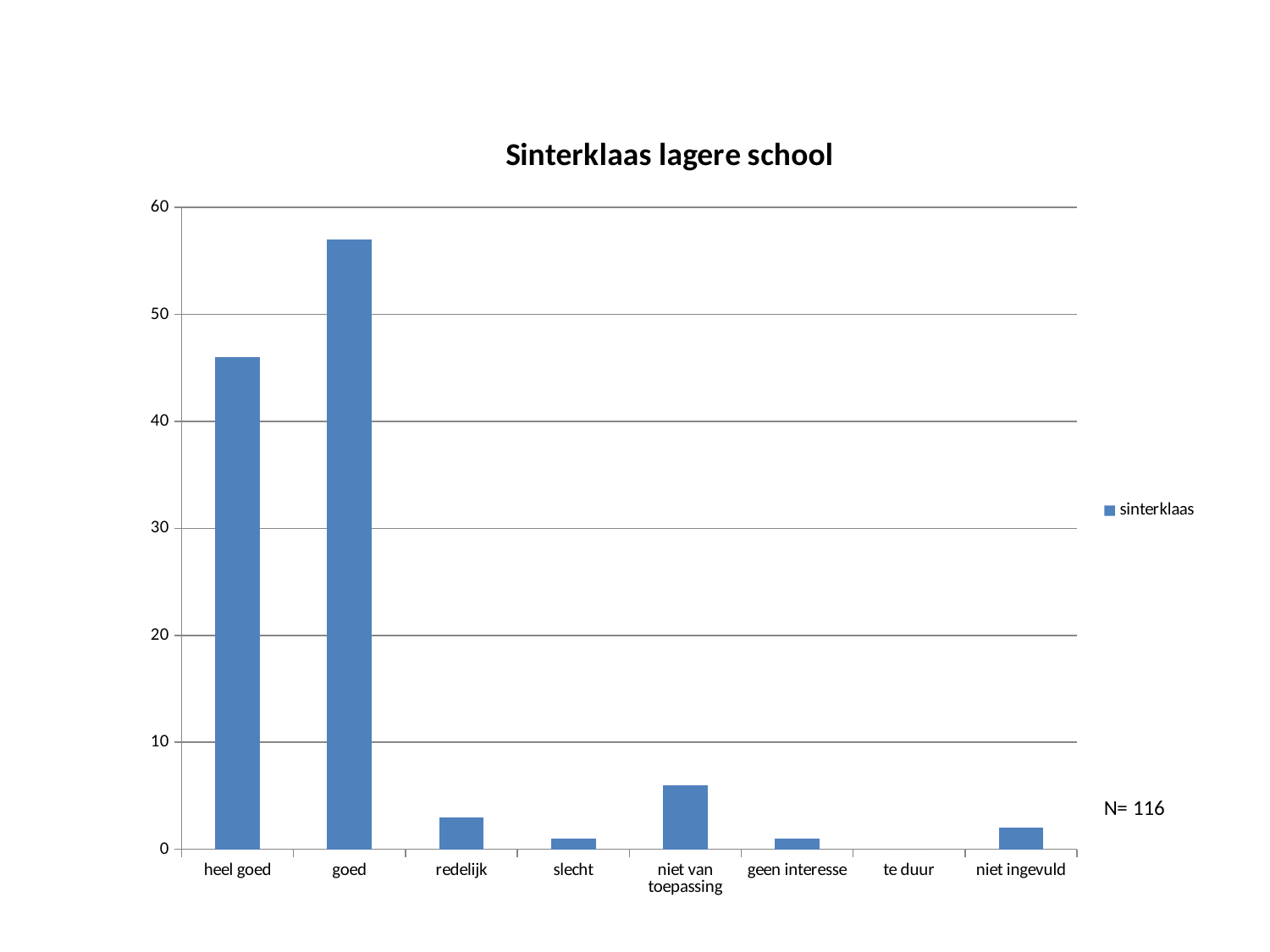
Which is larger, the value for heel goed or the value for goed? goed Is the value for niet van toepassing greater or less than 10? less What is the title of the chart? Sinterklaas lagere school How many series does the legend list? 1 What is the name of the series in the legend? sinterklaas Which category has the highest value? goed How many categories are shown on the x axis? 8 What kind of chart is shown on the slide? bar chart Is the value for goed greater or less than 50? greater Is the value for heel goed greater or less than 40? greater Which category has the lowest value? te duur Which is larger, the value for redelijk or the value for niet van toepassing? niet van toepassing